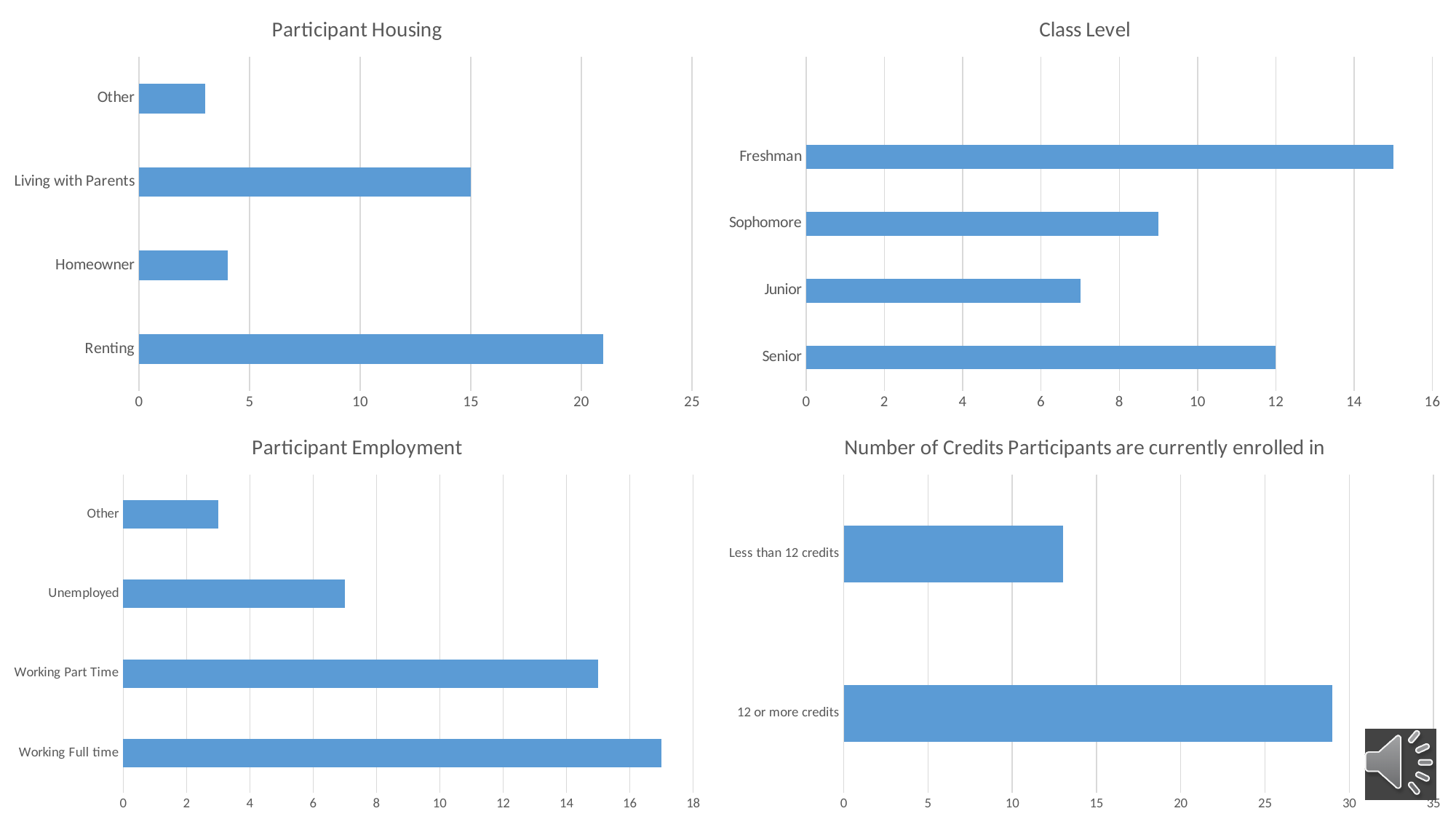
In the Class Level chart, which class level has the highest value? Freshman How many categories are shown in the Participant Employment chart? 4 In the Participant Housing chart, which category has the highest value? Renting In the Class Level chart, which class level has the lowest value? Junior In the Participant Employment chart, is the value for Working Part Time greater or less than 14? greater In the Number of Credits Participants are currently enrolled in chart, which category is larger, Less than 12 credits or 12 or more credits? 12 or more credits In the Number of Credits Participants are currently enrolled in chart, is the value for 12 or more credits greater or less than 25? greater In the Class Level chart, what is the value for Senior? 12 In the Participant Housing chart, what is the value for Living with Parents? 15 What kind of chart is the Class Level chart? Bar chart In the Participant Housing chart, which category has the lowest value? Other In the Participant Employment chart, which category has the highest value? Working Full time